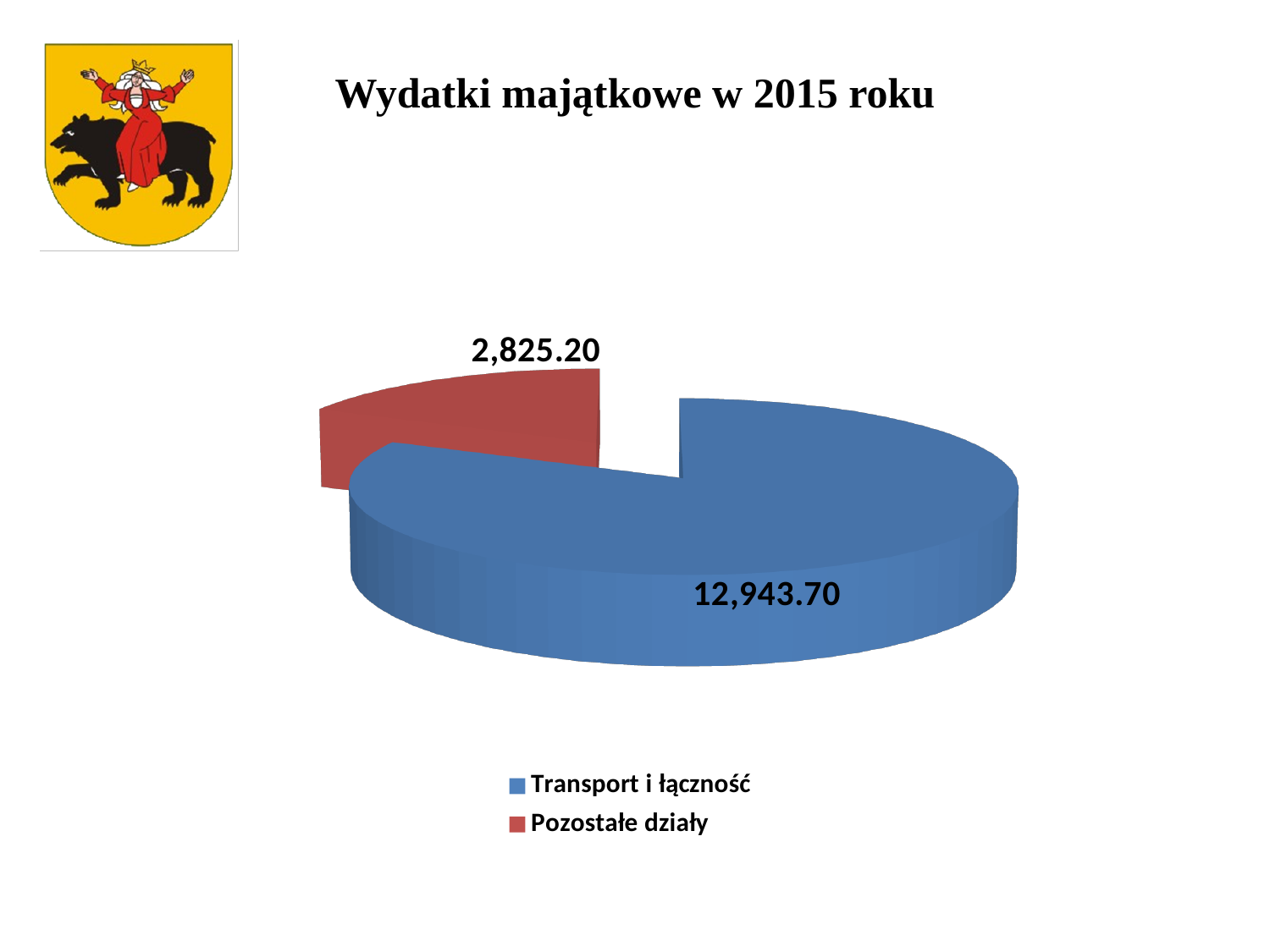
What kind of chart is shown on the slide? Pie chart What is the title of the slide? Wydatki majątkowe w 2015 roku What is the difference between the values for Transport i łączność and Pozostałe działy? 10,118.50 How many entries does the legend list? 2 How many slices does the pie chart have? 2 Which category has the largest slice of the pie? Transport i łączność Which is larger, the value for Transport i łączność or the value for Pozostałe działy? Transport i łączność What is the value for Pozostałe działy? 2,825.20 What share of the total does Transport i łączność represent, rounded to one decimal place? 82.1% What is the value for Transport i łączność? 12,943.70 What is the total of the two slices in the pie chart? 15,768.90 Which category has the smallest slice of the pie? Pozostałe działy